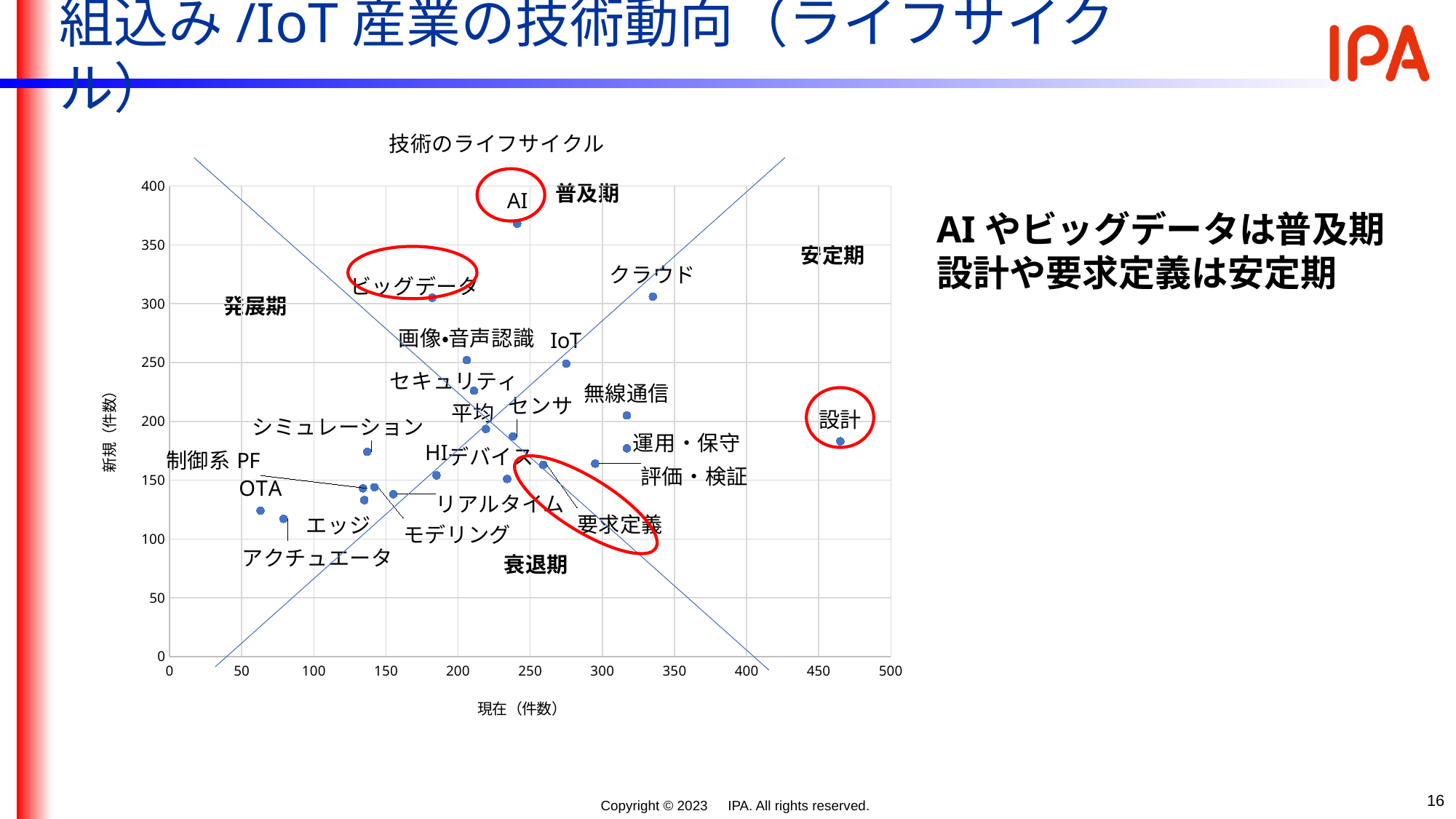
Which labeled point has the highest 現在（件数） value? 設計 Is the 新規（件数） value for IoT greater or less than 200? greater What is the title of the chart? 技術のライフサイクル Is the 現在（件数） value for 設計 greater or less than 450? greater What is the label of the horizontal axis of the chart? 現在（件数） Which has the higher 現在（件数） value, 設計 or クラウド? 設計 Which has the higher 新規（件数） value, AI or クラウド? AI Is the 新規（件数） value for AI greater or less than 350? greater What kind of chart is shown on the slide? scatter chart Which labeled point has the highest 新規（件数） value? AI